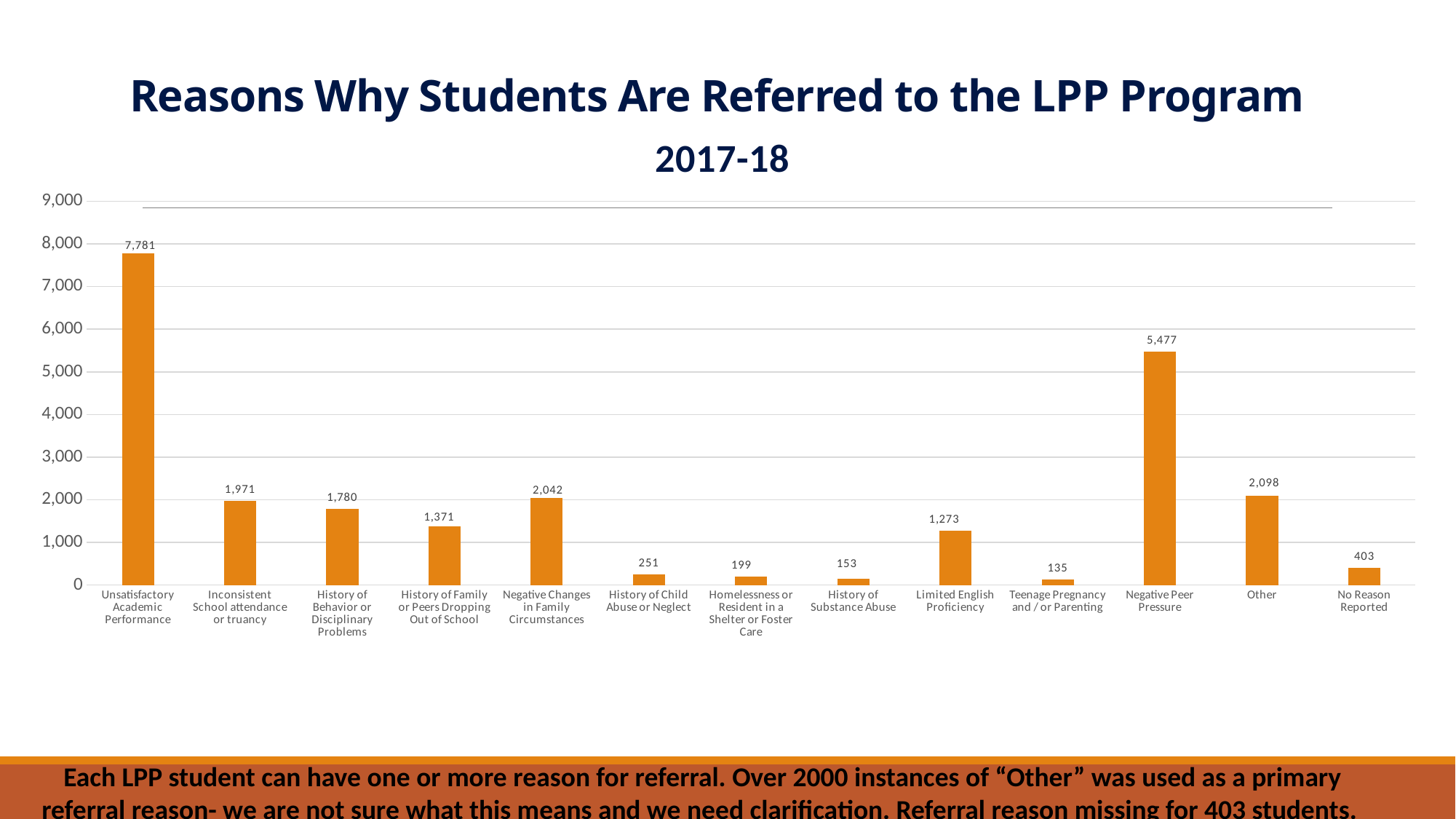
What kind of chart is shown on the slide? Bar chart What is the value for Teenage Pregnancy and / or Parenting? 135 Is the value for Limited English Proficiency greater or less than 1,000? greater What is the value for No Reason Reported? 403 What is the value for Unsatisfactory Academic Performance? 7,781 How many categories are shown on the chart? 13 Which is larger, Other or Negative Changes in Family Circumstances? Other Which category has the highest value? Unsatisfactory Academic Performance Which category has the lowest value? Teenage Pregnancy and / or Parenting What is the value for Negative Peer Pressure? 5,477 What is the difference between Unsatisfactory Academic Performance and Negative Peer Pressure? 2,304 What is the title of the chart? Reasons Why Students Are Referred to the LPP Program 2017-18